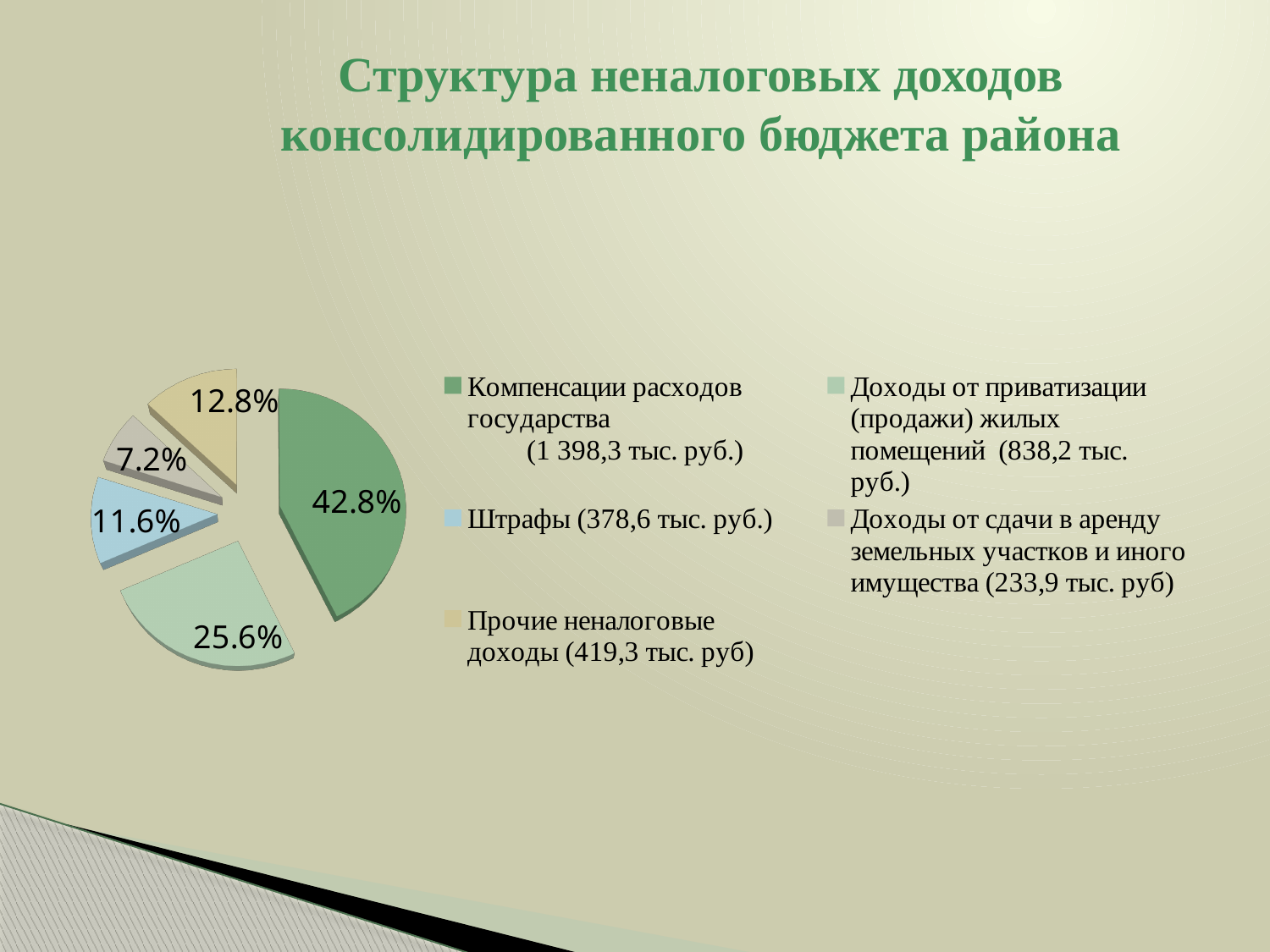
Which slice is larger: "Штрафы" or "Прочие неналоговые доходы"? Прочие неналоговые доходы Which category has the smallest slice of the pie? Доходы от сдачи в аренду земельных участков и иного имущества What kind of chart is shown on the slide? pie chart What share of the pie does "Прочие неналоговые доходы" have? 12.8% What share of the pie does "Штрафы" have? 11.6% What share of the pie does "Доходы от приватизации (продажи) жилых помещений" have? 25.6% What is the difference in percentage points between the "Компенсации расходов государства" slice and the "Доходы от приватизации (продажи) жилых помещений" slice? 17.2 What amount in thousand rubles does the legend give for "Штрафы"? 378,6 тыс. руб. How many slices does the pie chart have? 5 Which category has the largest slice of the pie? Компенсации расходов государства